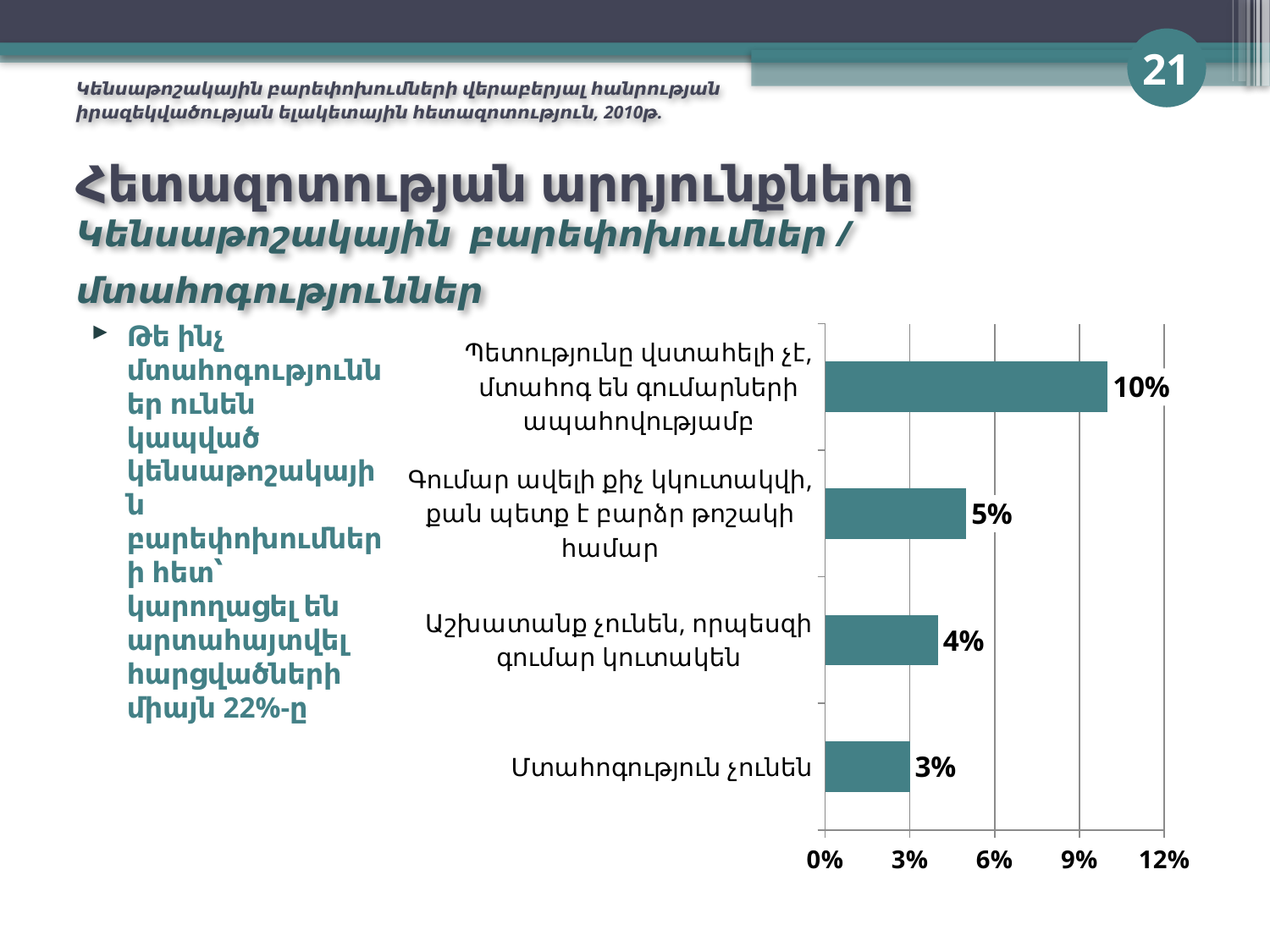
What value is shown for the category "Մտահոգություն չունեն"? 3% What is the difference between the values for "Պետությունը վստահելի չէ, մտահոգ են գումարների ապահովությամբ" and "Գումար ավելի քիչ կկուտակվի, քան պետք է բարձր թոշակի համար"? 5% What is the maximum value shown on the chart's horizontal axis? 12% What value is shown for the category "Գումար ավելի քիչ կկուտակվի, քան պետք է բարձր թոշակի համար"? 5% What kind of chart is shown on the slide? bar chart Is the value for "Պետությունը վստահելի չէ, մտահոգ են գումարների ապահովությամբ" greater or less than 9%? greater Which is larger: the value for "Աշխատանք չունեն, որպեսզի գումար կուտակեն" or the value for "Մտահոգություն չունեն"? Աշխատանք չունեն, որպեսզի գումար կուտակեն How many categories are shown in the chart? 4 What value is shown for the category "Պետությունը վստահելի չէ, մտահոգ են գումարների ապահովությամբ"? 10% What value is shown for the category "Աշխատանք չունեն, որպեսզի գումար կուտակեն"? 4% Which category has the highest value in the chart? Պետությունը վստահելի չէ, մտահոգ են գումարների ապահովությամբ Which category has the lowest value in the chart? Մտահոգություն չունեն